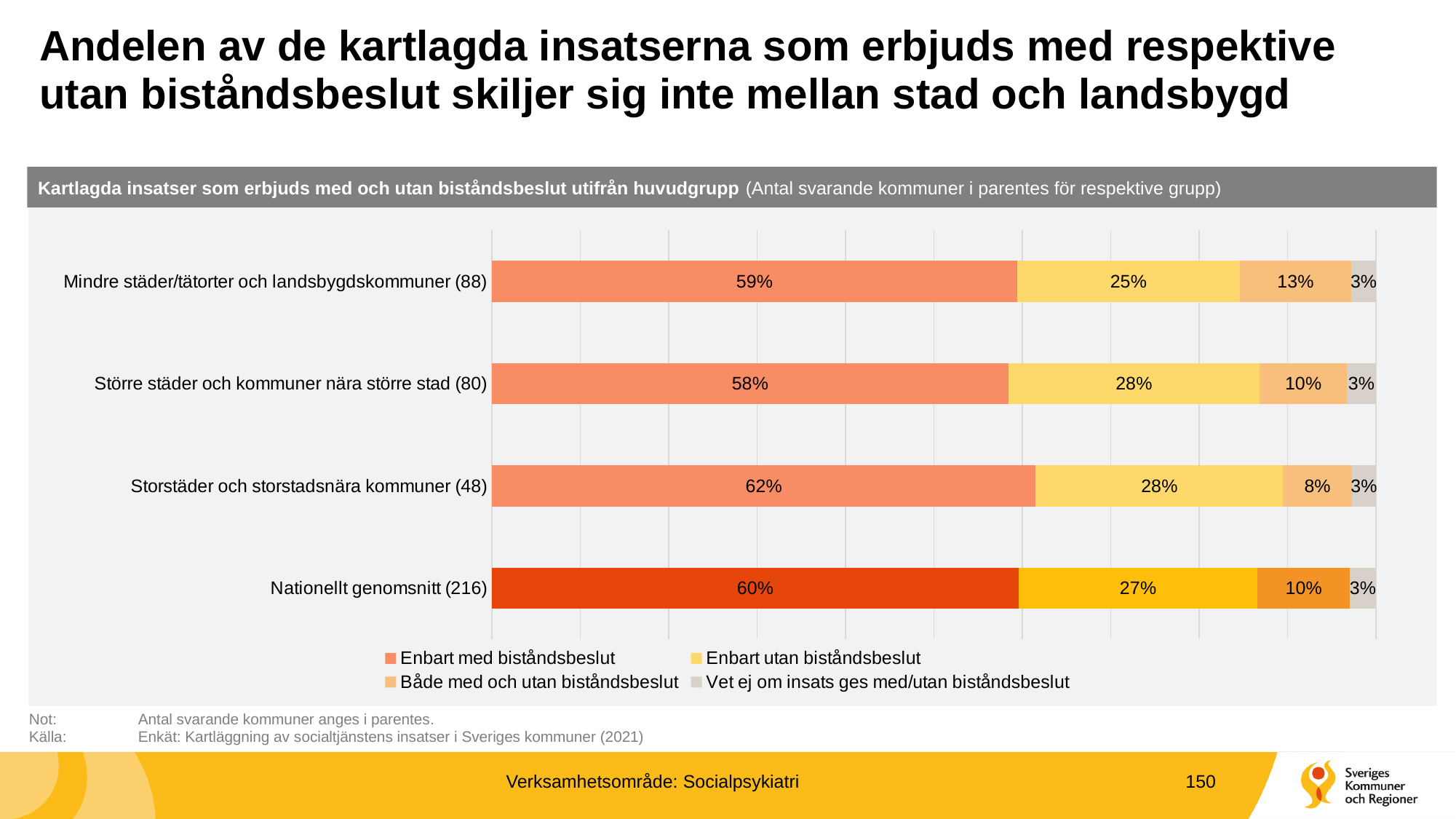
What is the value for 'Enbart utan biståndsbeslut' for Mindre städer/tätorter och landsbygdskommuner (88)? 25% Which category has the lowest value for 'Både med och utan biståndsbeslut'? Storstäder och storstadsnära kommuner (48) What is the difference in 'Enbart med biståndsbeslut' between Storstäder och storstadsnära kommuner (48) and Större städer och kommuner nära större stad (80)? 4 percentage points What is the value for 'Vet ej om insats ges med/utan biståndsbeslut' for Större städer och kommuner nära större stad (80)? 3% How many series does the legend list? 4 What is the total of the stacked bar for Nationellt genomsnitt (216)? 100% What is the value for 'Både med och utan biståndsbeslut' for Nationellt genomsnitt (216)? 10% Which has the larger value for 'Enbart utan biståndsbeslut': Större städer och kommuner nära större stad (80) or Mindre städer/tätorter och landsbygdskommuner (88)? Större städer och kommuner nära större stad (80) Which category has the highest value for 'Enbart med biståndsbeslut'? Storstäder och storstadsnära kommuner (48) What is the value for 'Enbart med biståndsbeslut' for Storstäder och storstadsnära kommuner (48)? 62% What kind of chart is shown on the slide? Stacked bar chart How many categories (bars) are shown in the chart? 4